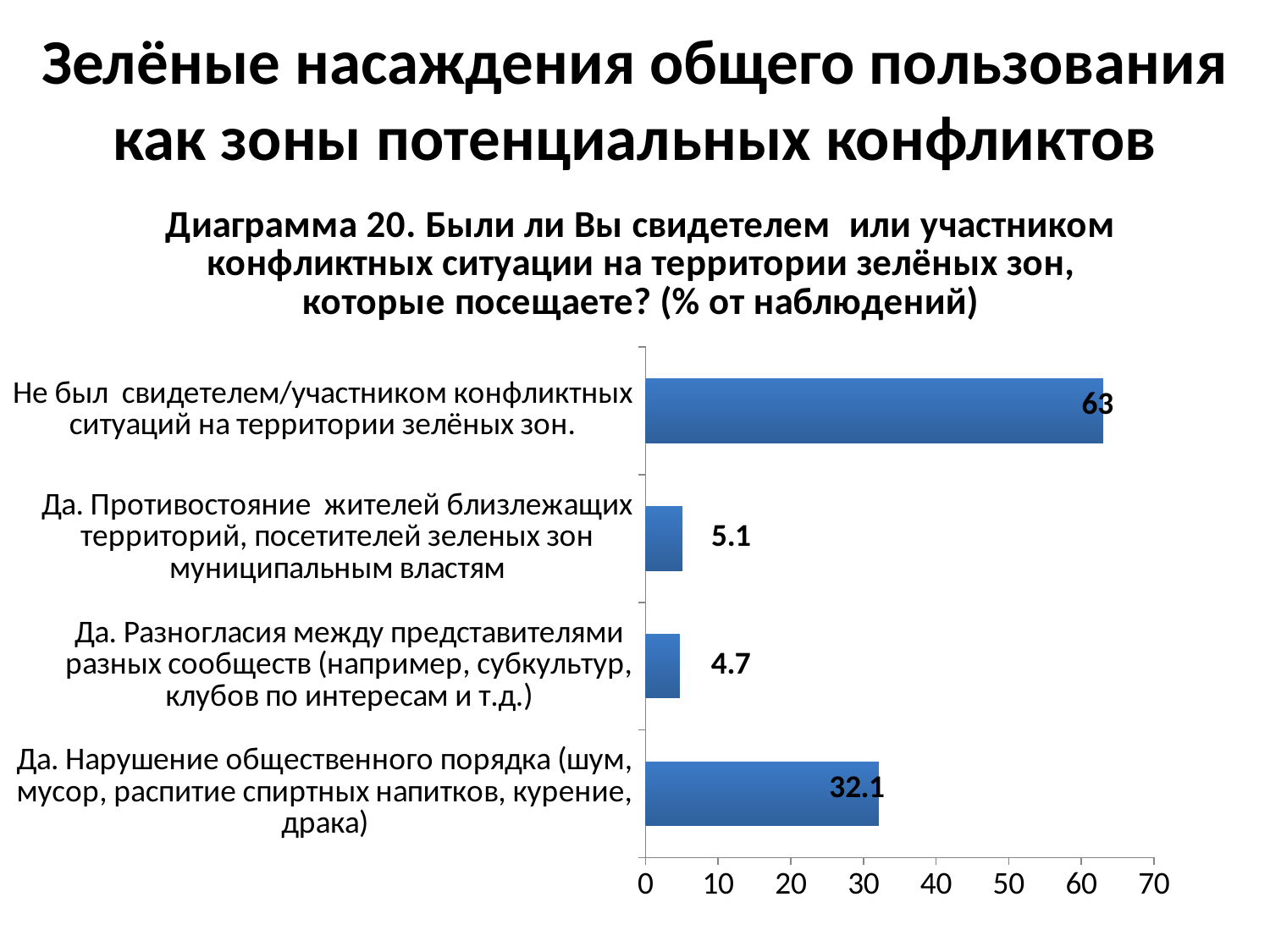
Which category has the highest value? Не был свидетелем/участником конфликтных ситуаций на территории зелёных зон. What kind of chart is shown on the slide? bar chart Is the value for "Да. Нарушение общественного порядка (шум, мусор, распитие спиртных напитков, курение, драка)" greater or less than 30? greater What is the value for "Не был свидетелем/участником конфликтных ситуаций на территории зелёных зон."? 63 How many categories are shown in the chart? 4 Which category has the lowest value? Да. Разногласия между представителями разных сообществ (например, субкультур, клубов по интересам и т.д.) What is the maximum value shown on the horizontal axis of the chart? 70 What is the value for "Да. Разногласия между представителями разных сообществ (например, субкультур, клубов по интересам и т.д.)"? 4.7 What is the value for "Да. Противостояние жителей близлежащих территорий, посетителей зеленых зон муниципальным властям"? 5.1 What is the difference between the value for "Не был свидетелем/участником конфликтных ситуаций на территории зелёных зон." and the value for "Да. Нарушение общественного порядка (шум, мусор, распитие спиртных напитков, курение, драка)"? 30.9 Which is larger: the value for "Да. Противостояние жителей близлежащих территорий, посетителей зеленых зон муниципальным властям" or the value for "Да. Разногласия между представителями разных сообществ (например, субкультур, клубов по интересам и т.д.)"? Да. Противостояние жителей близлежащих территорий, посетителей зеленых зон муниципальным властям What is the value for "Да. Нарушение общественного порядка (шум, мусор, распитие спиртных напитков, курение, драка)"? 32.1